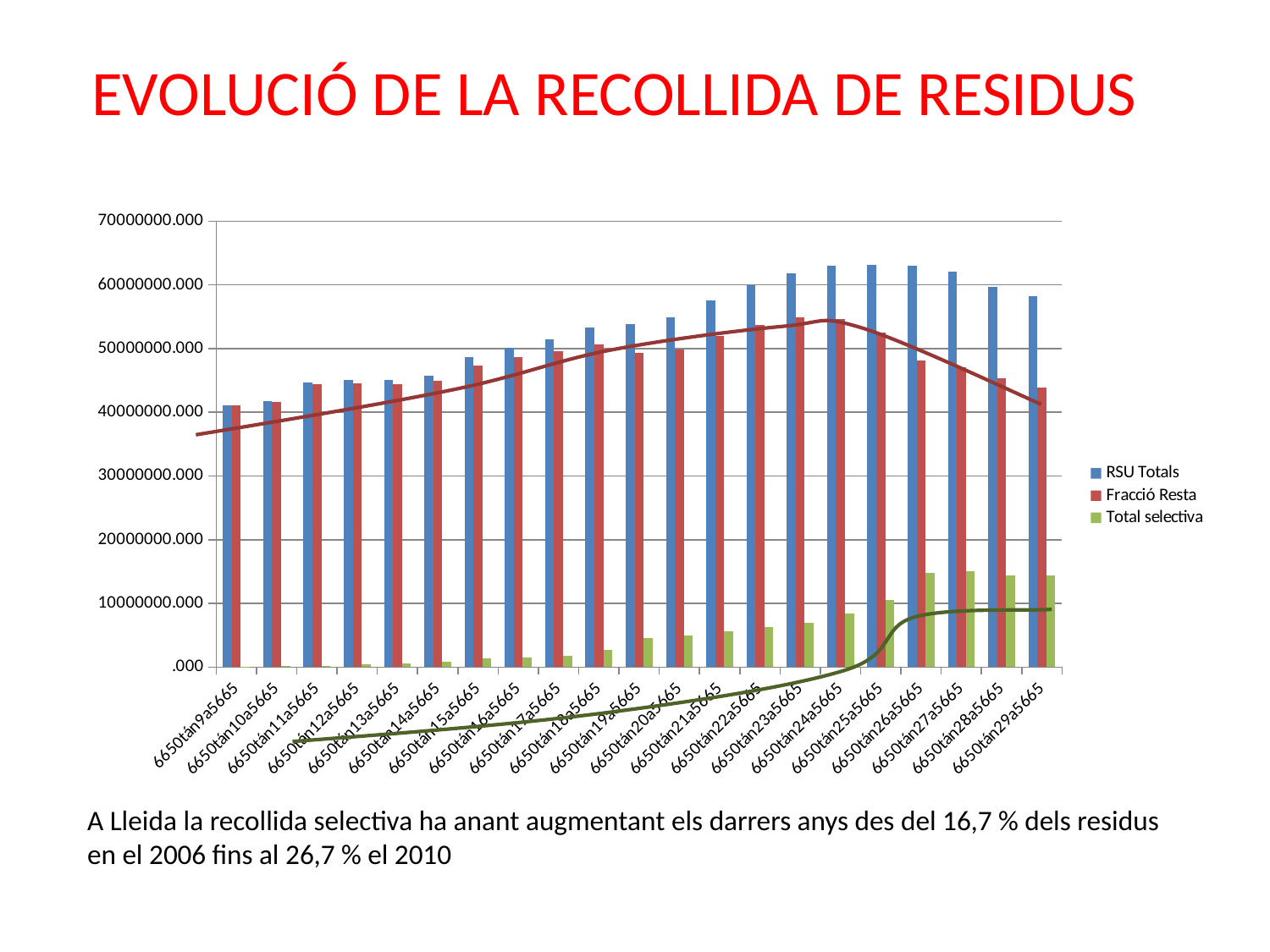
What kind of chart is shown on the slide? bar chart Which series is shown in green in the legend? Total selectiva How many categories are shown along the x axis? 21 How many series does the legend list? 3 Is the Total selectiva value for 6650tán29a5665 greater or less than 10000000.000? greater Does the Total selectiva series generally rise or fall from left to right along the x axis? rise Is the Fracció Resta value for 6650tán29a5665 greater or less than 50000000.000? less Is the RSU Totals value for 6650tán24a5665 greater or less than 60000000.000? greater What is the title of the slide containing the chart? EVOLUCIÓ DE LA RECOLLIDA DE RESIDUS For 6650tán29a5665, which is larger: RSU Totals or Fracció Resta? RSU Totals Which has the larger Total selectiva value: 6650tán9a5665 or 6650tán29a5665? 6650tán29a5665